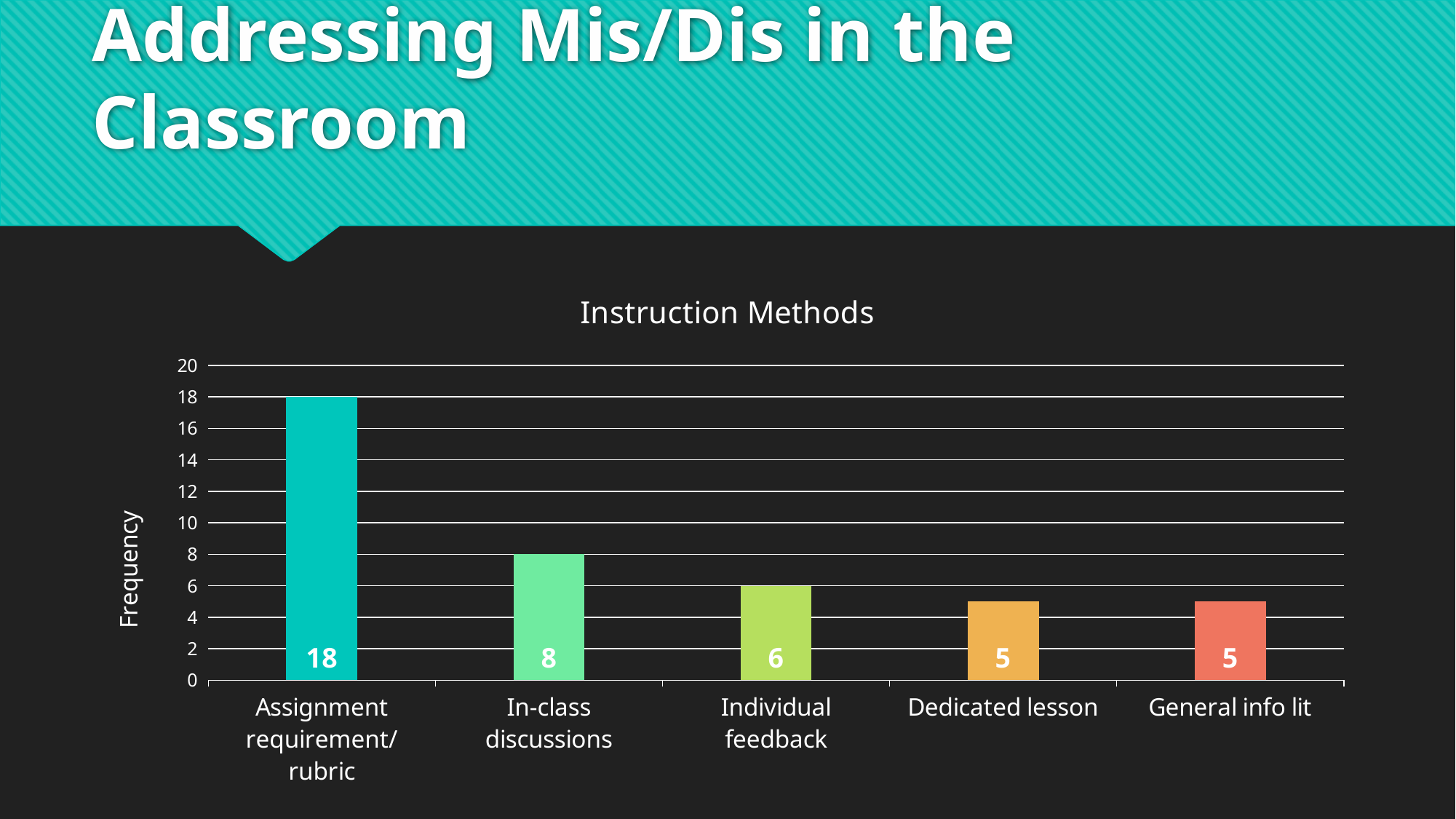
Do the values rise or fall from left to right across the categories? Fall What is the title of the chart? Instruction Methods What kind of chart is shown on the slide? Bar chart How many instruction methods are shown in the chart? 5 What is the frequency for In-class discussions? 8 What is the frequency for Assignment requirement/rubric? 18 Which has a higher frequency, Individual feedback or Dedicated lesson? Individual feedback What is the difference in frequency between Assignment requirement/rubric and In-class discussions? 10 Is the value for Assignment requirement/rubric greater or less than 10? greater What is the frequency for Individual feedback? 6 Which instruction method has the highest frequency? Assignment requirement/rubric What is the difference in frequency between In-class discussions and Dedicated lesson? 3